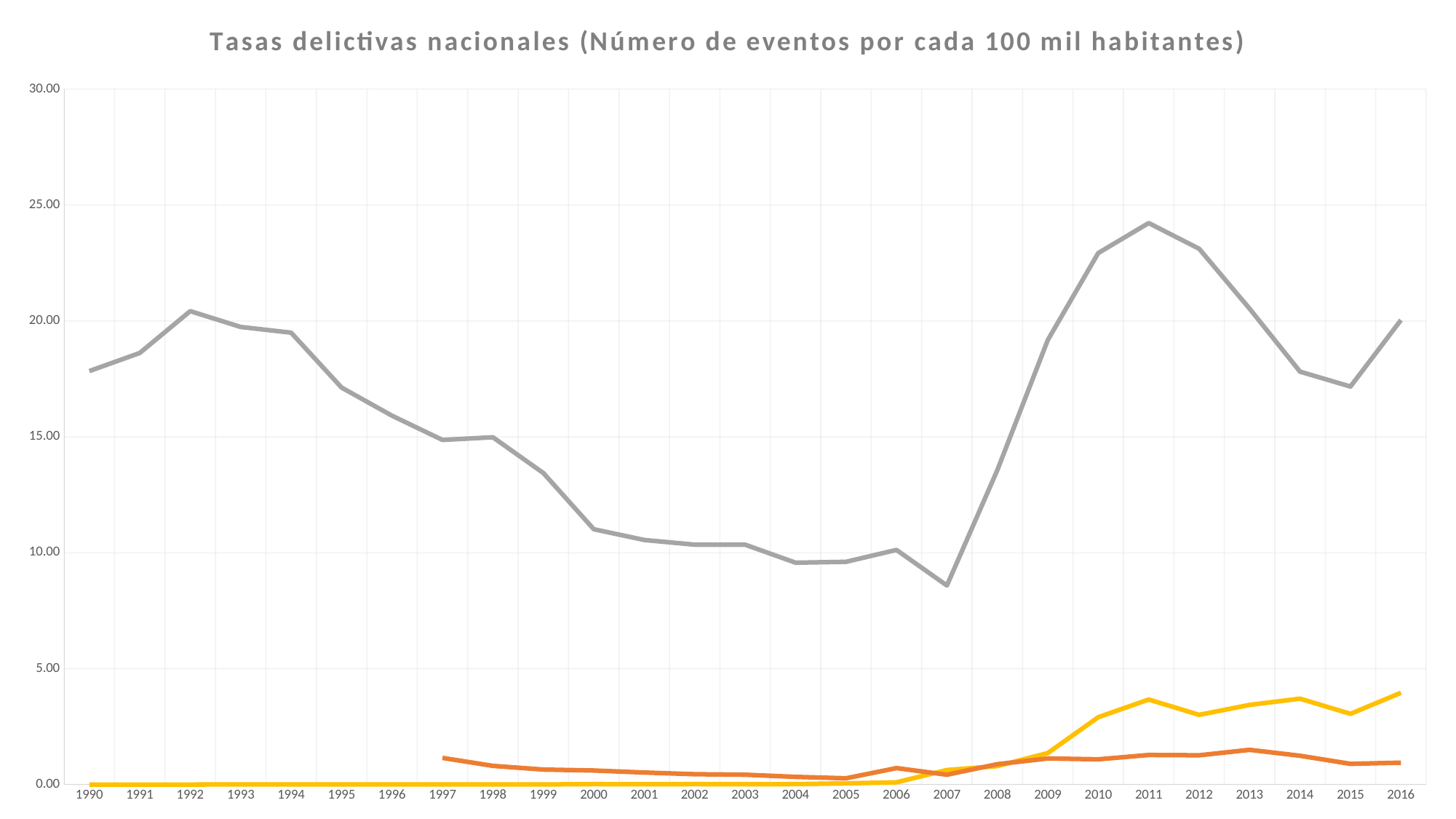
Does the gray line rise or fall between 2007 and 2011? rise Which year has a higher value on the gray line, 1992 or 2000? 1992 In which year does the gray line reach its lowest value? 2007 What is the title of the chart? Tasas delictivas nacionales (Número de eventos por cada 100 mil habitantes) Does the gray line rise or fall between 1992 and 2007? fall Is the value of the gray line in 2007 greater or less than 10.00? less In which year does the gray line reach its highest value? 2011 Is the value of the gray line in 2011 greater or less than 20.00? greater Is the value of the gray line in 1990 greater or less than 15.00? greater What kind of chart is shown on the slide? line chart How many years are shown along the x axis of the chart? 27